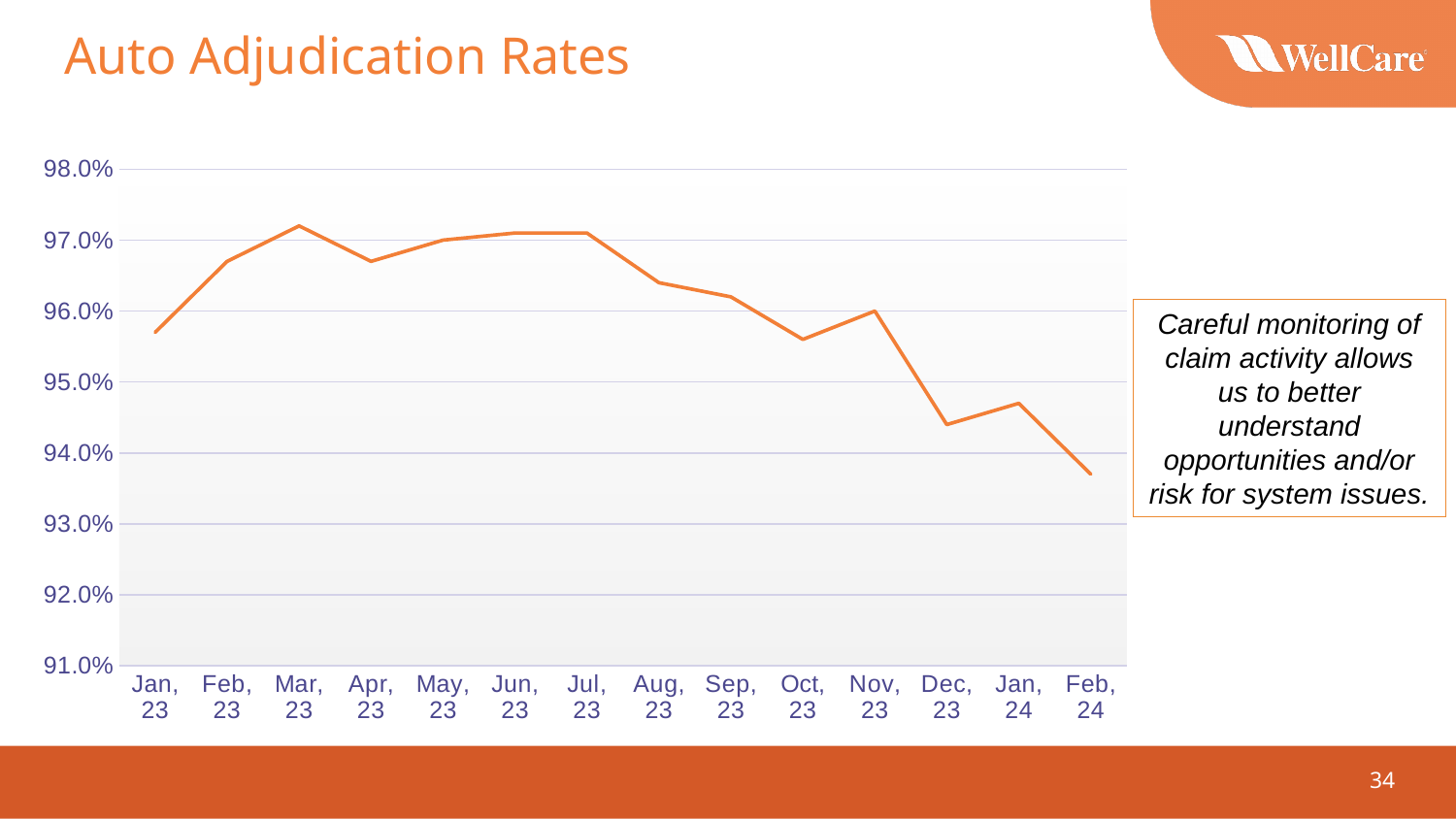
Is the value for Feb, 24 greater or less than 94.0%? less Which month has the lowest auto adjudication rate? Feb, 24 Do the values generally rise or fall from Jul, 23 to Feb, 24? fall What is the title of the chart? Auto Adjudication Rates Is the value for Mar, 23 greater or less than 97.0%? greater What is the lowest value shown on the vertical axis? 91.0% What kind of chart is shown on the slide? line chart Is the value for Dec, 23 greater or less than 95.0%? less Which month has the highest auto adjudication rate? Mar, 23 Which is larger, the value for Nov, 23 or the value for Dec, 23? Nov, 23 How many monthly data points are plotted on the chart? 14